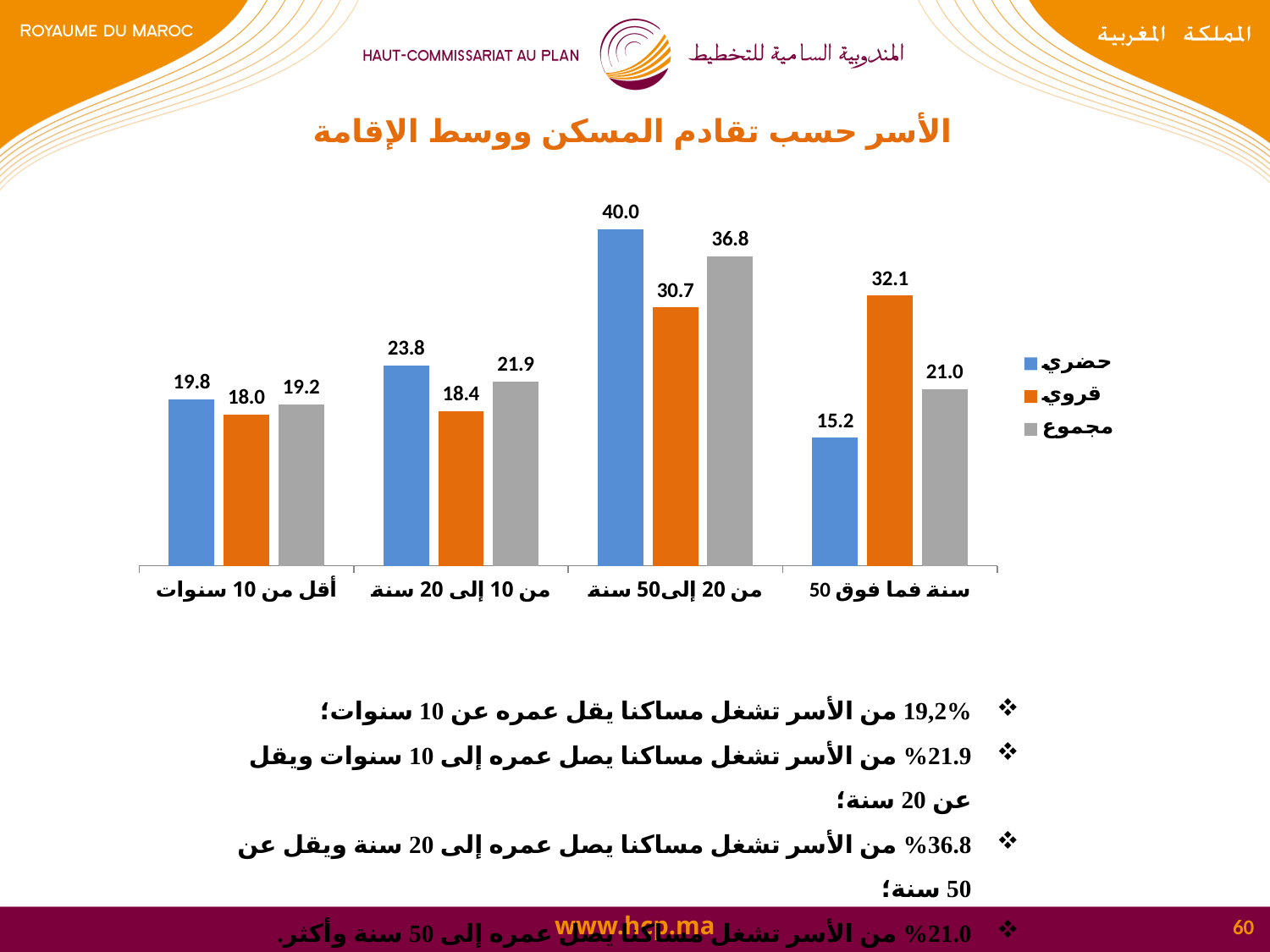
What is the value for قروي in the category 50 سنة فما فوق? 32.1 How many categories are shown on the x axis? 4 Which category has the lowest value for the حضري series? 50 سنة فما فوق What is the value for قروي in the category أقل من 10 سنوات? 18.0 How many series does the legend list? 3 What is the value for مجموع in the category من 10 إلى 20 سنة? 21.9 What is the difference between the حضري and قروي values in the category من 20 إلى50 سنة? 9.3 Which category has the highest value for the حضري series? من 20 إلى50 سنة What kind of chart is shown on the slide? bar chart What colour represents the قروي series? orange What is the value for حضري in the category من 20 إلى50 سنة? 40.0 In the category 50 سنة فما فوق, which is larger: حضري or قروي? قروي